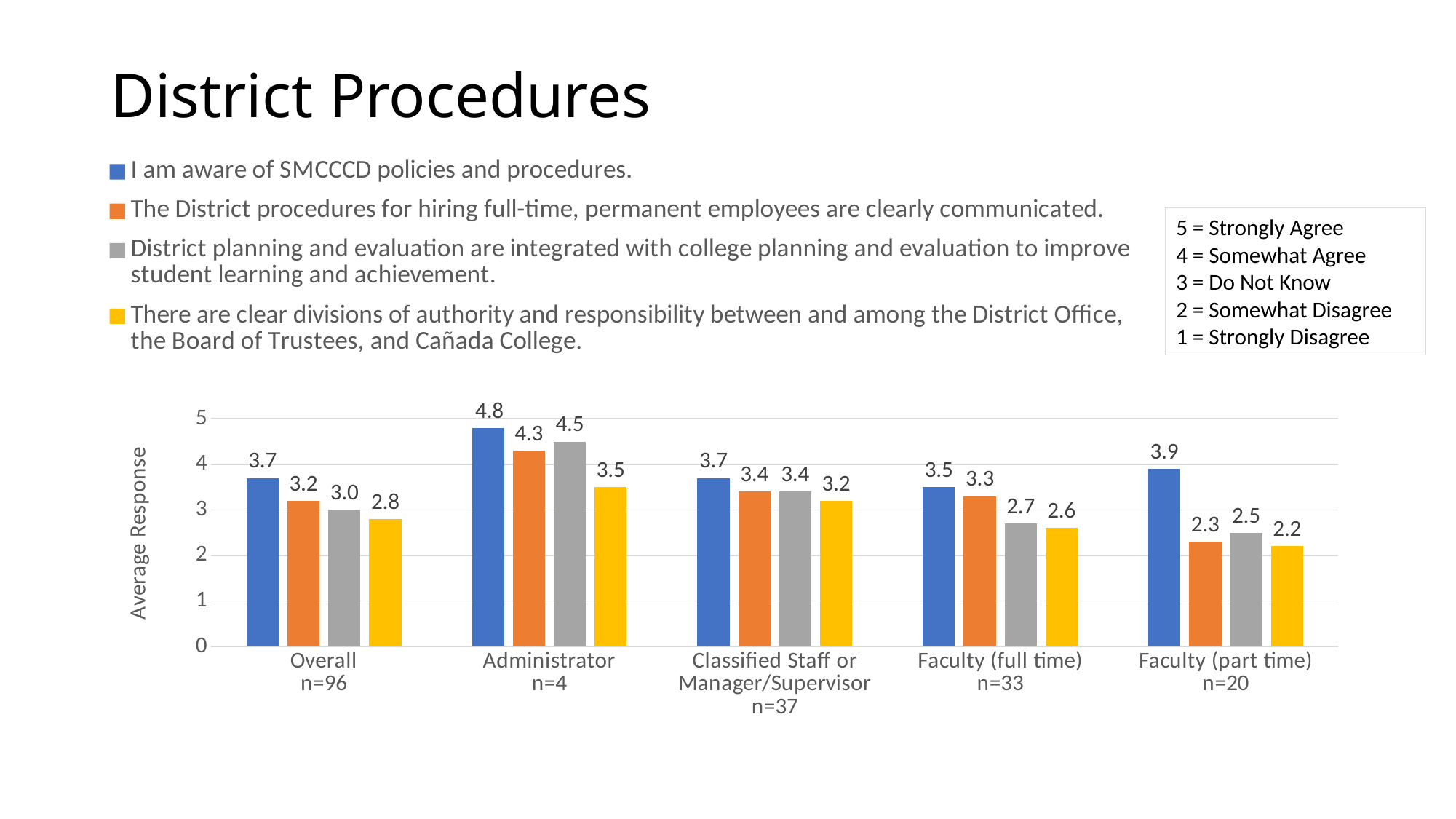
What kind of chart is shown on the slide? Bar chart What is the average response for Administrator on 'I am aware of SMCCCD policies and procedures'? 4.8 Which is larger: the Faculty (full time) value for 'I am aware of SMCCCD policies and procedures' or the Faculty (part time) value for the same statement? Faculty (part time) What is the average response for Faculty (part time) on 'There are clear divisions of authority and responsibility between and among the District Office, the Board of Trustees, and Cañada College'? 2.2 Which group has the lowest average response for 'The District procedures for hiring full-time, permanent employees are clearly communicated'? Faculty (part time) What is the Overall average response for 'The District procedures for hiring full-time, permanent employees are clearly communicated'? 3.2 How many series does the legend list? 4 What is the sample size (n) for the Classified Staff or Manager/Supervisor group? n=37 Which group has the highest average response for 'District planning and evaluation are integrated with college planning and evaluation to improve student learning and achievement'? Administrator What is the label of the vertical axis? Average Response What is the difference between the Administrator and Faculty (part time) average responses for 'I am aware of SMCCCD policies and procedures'? 0.9 How many respondent groups are shown on the x axis? 5